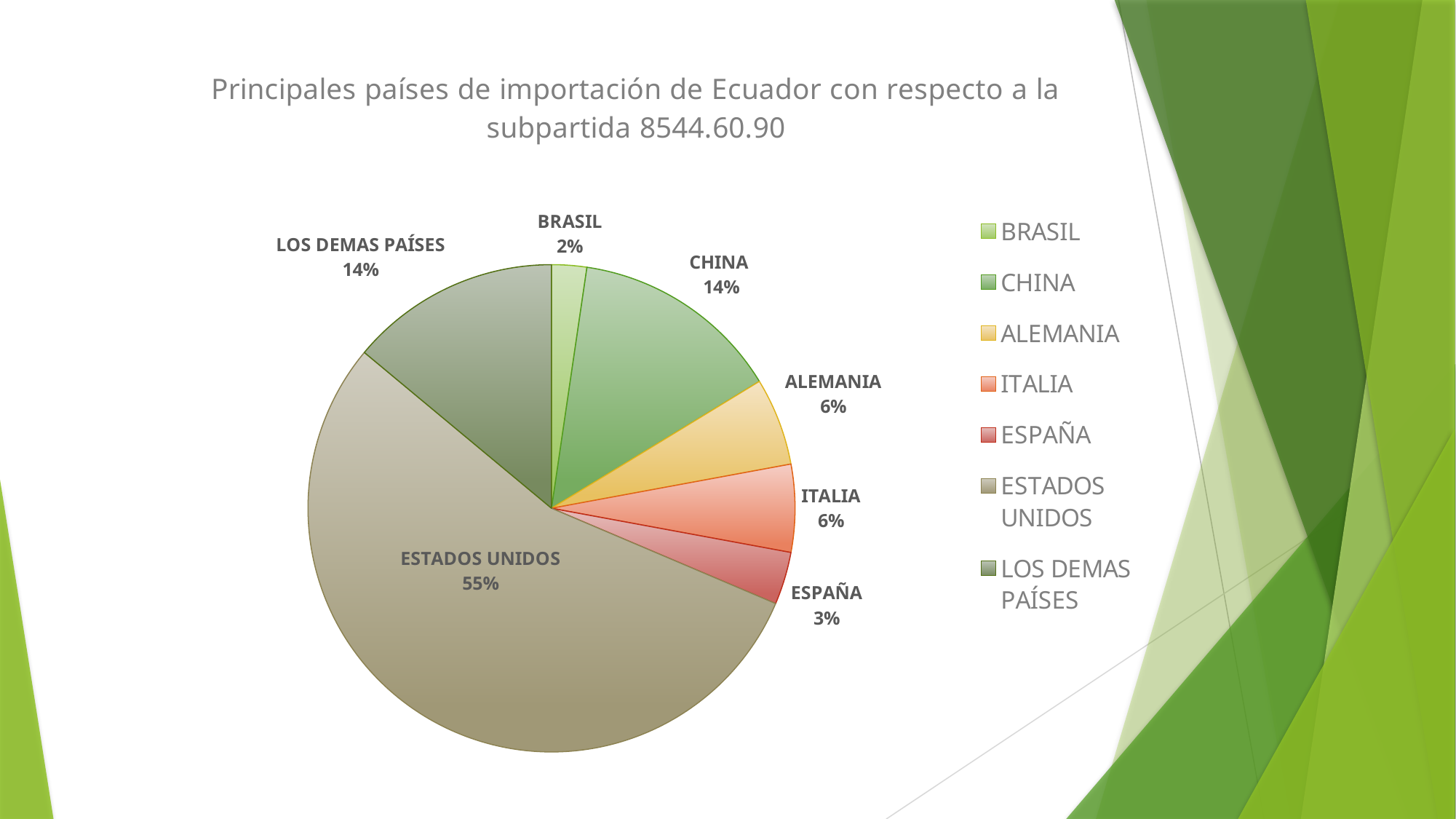
What is the difference between the shares of ESTADOS UNIDOS and CHINA? 41% What is the value shown for CHINA? 14% What is the title of the chart? Principales países de importación de Ecuador con respecto a la subpartida 8544.60.90 Which country has the largest slice of the pie? ESTADOS UNIDOS What is the value shown for ESPAÑA? 3% How many slices does the pie chart have? 7 Which is larger, the share for ALEMANIA or the share for ESPAÑA? ALEMANIA What is the value shown for BRASIL? 2% Which category has the smallest slice of the pie? BRASIL What type of chart is shown on the slide? pie chart How many entries does the legend list? 7 What share of the pie does ESTADOS UNIDOS hold? 55%